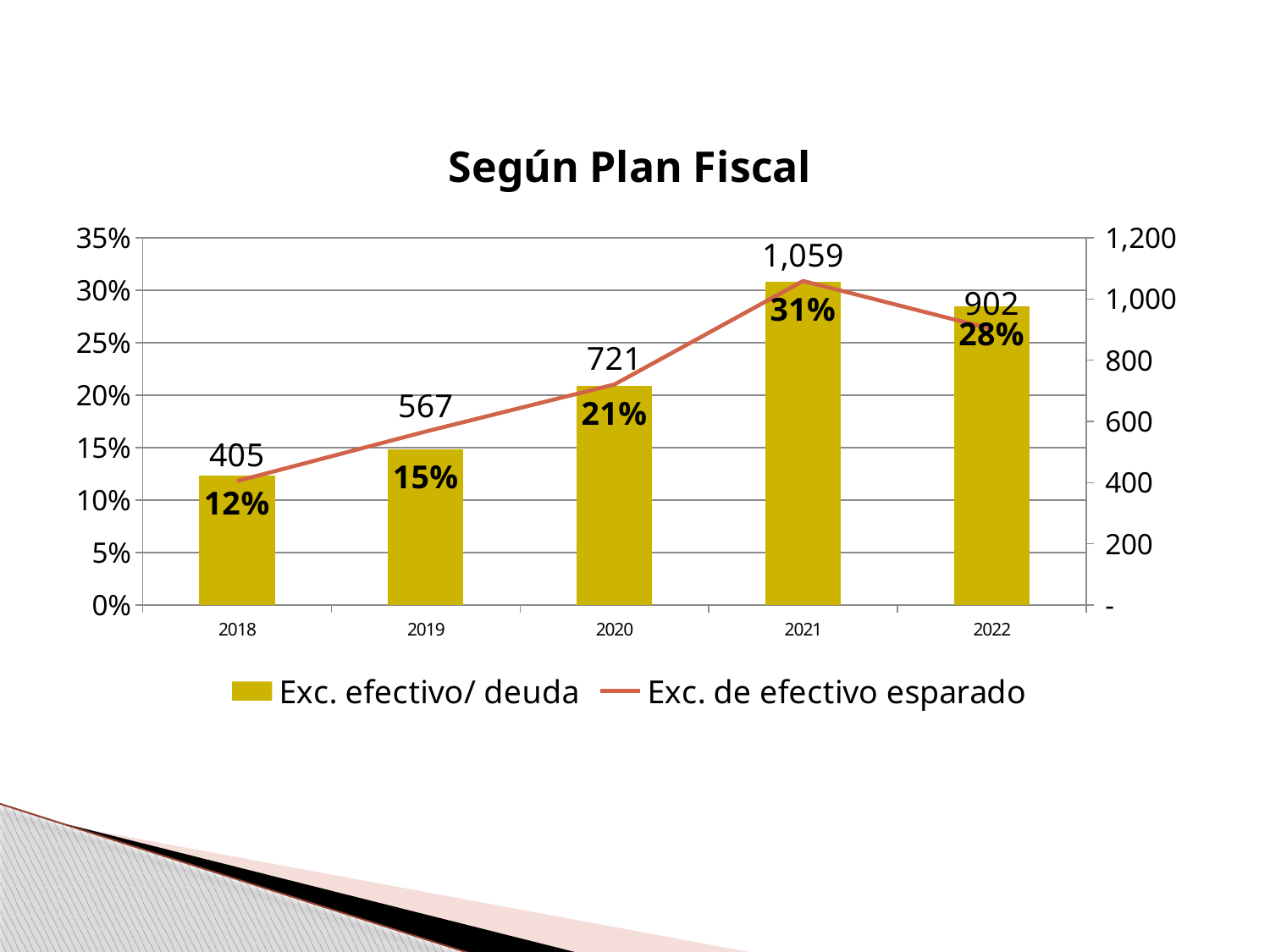
What is the value of Exc. efectivo/ deuda for 2018? 12% Which year has the highest Exc. efectivo/ deuda? 2021 Which year has the lowest Exc. de efectivo esparado? 2018 What is the value of Exc. de efectivo esparado for 2019? 567 What is the difference in Exc. de efectivo esparado between 2021 and 2022? 157 What is the value of Exc. de efectivo esparado for 2021? 1,059 What kinds of chart are combined on this slide? Bar chart and line chart What is the value of Exc. efectivo/ deuda for 2022? 28% Which is larger, Exc. efectivo/ deuda in 2020 or in 2019? 2020 How many series does the legend list? 2 What is the title of the chart? Según Plan Fiscal How many years are shown on the x axis? 5